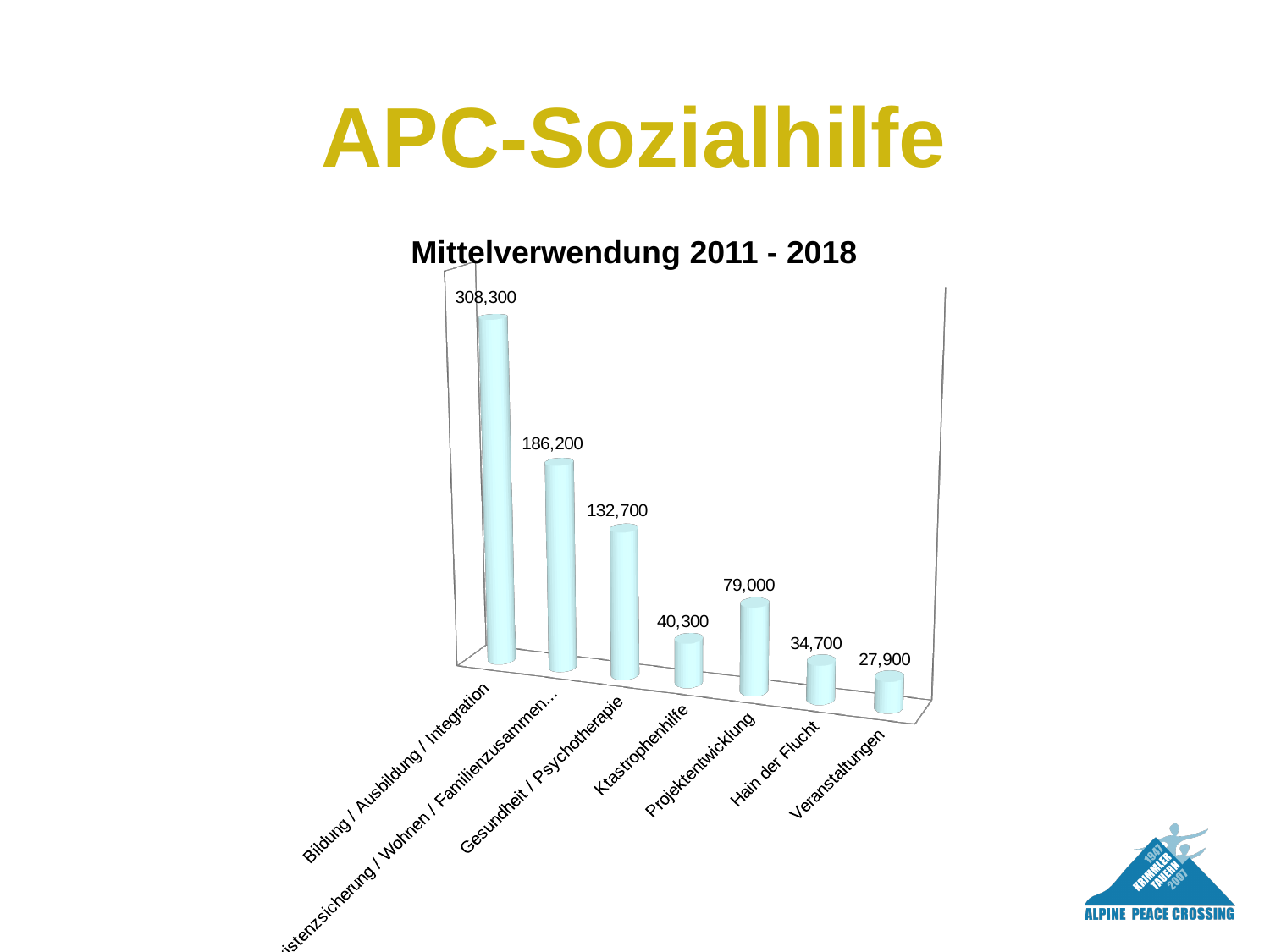
What is the value for Projektentwicklung? 79,000 What is the value for Hain der Flucht? 34,700 What is the value for Gesundheit / Psychotherapie? 132,700 What kind of chart is shown on the slide? Bar chart How many categories are shown in the chart? 7 Which category has the lowest value? Veranstaltungen Which category has the highest value? Bildung / Ausbildung / Integration What is the difference between the values for Projektentwicklung and Ktastrophenhilfe? 38,700 What is the title of the chart? Mittelverwendung 2011 - 2018 Which is larger, the value for Hain der Flucht or the value for Veranstaltungen? Hain der Flucht What is the value shown on the second bar from the left? 186,200 What is the value for Bildung / Ausbildung / Integration? 308,300